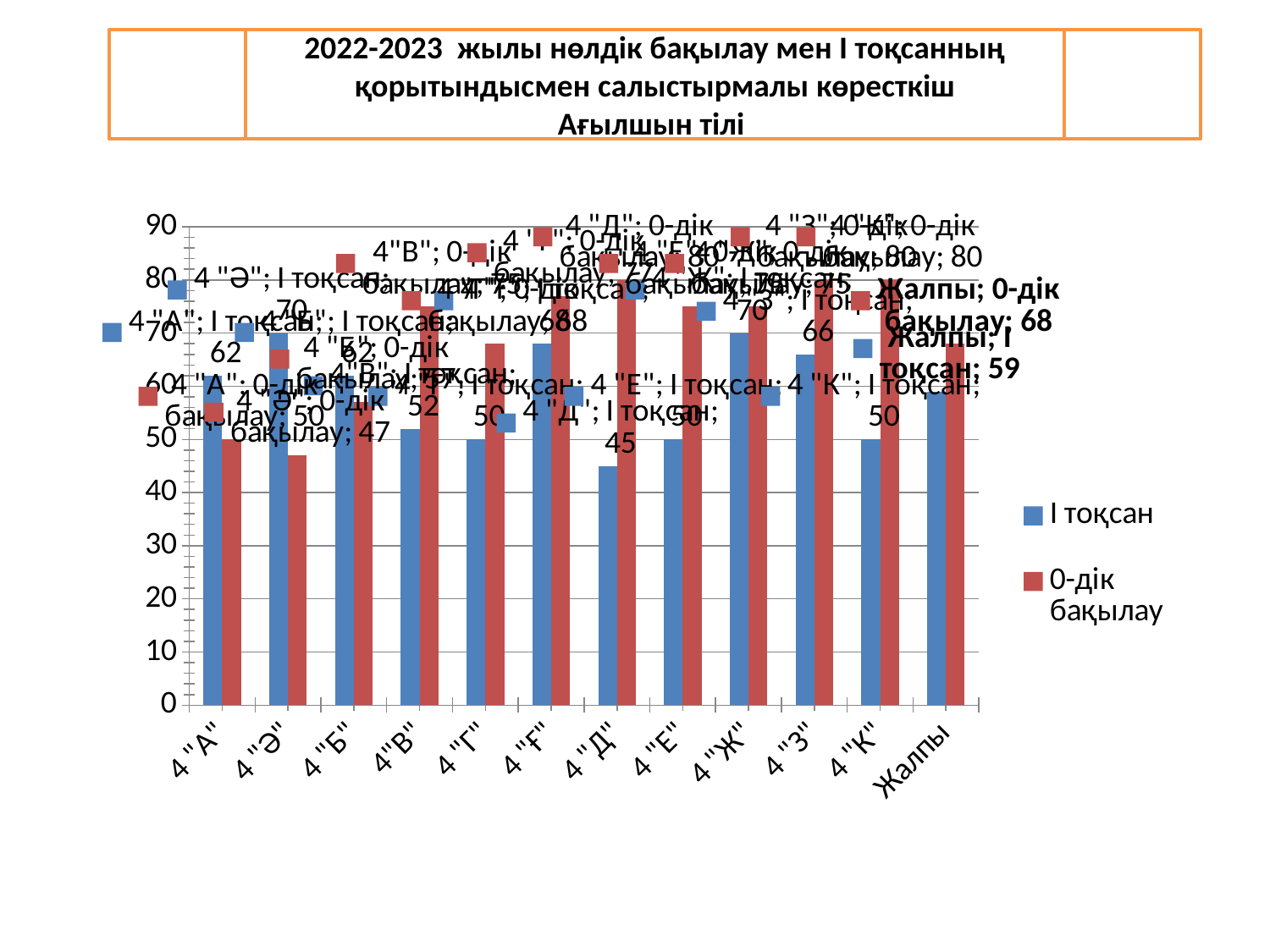
What is the value of the "Жалпы" category for the "0-дік бақылау" series? 68 How many series does the legend list? 2 What kind of chart is shown on the slide? bar chart For "Жалпы", which series has the larger value, "І тоқсан" or "0-дік бақылау"? 0-дік бақылау Which category has the lowest "І тоқсан" value? 4 "Д" What is the difference between the "0-дік бақылау" and "І тоқсан" values for "Жалпы"? 9 Is the "0-дік бақылау" value for 4 "Ғ" greater or less than 80? less How many categories are shown on the x axis? 12 What is the "І тоқсан" value for 4 "Ә"? 70 What is the value of the "Жалпы" category for the "І тоқсан" series? 59 What is the "І тоқсан" value for 4 "З"? 66 What is the "І тоқсан" value for 4 "Д"? 45